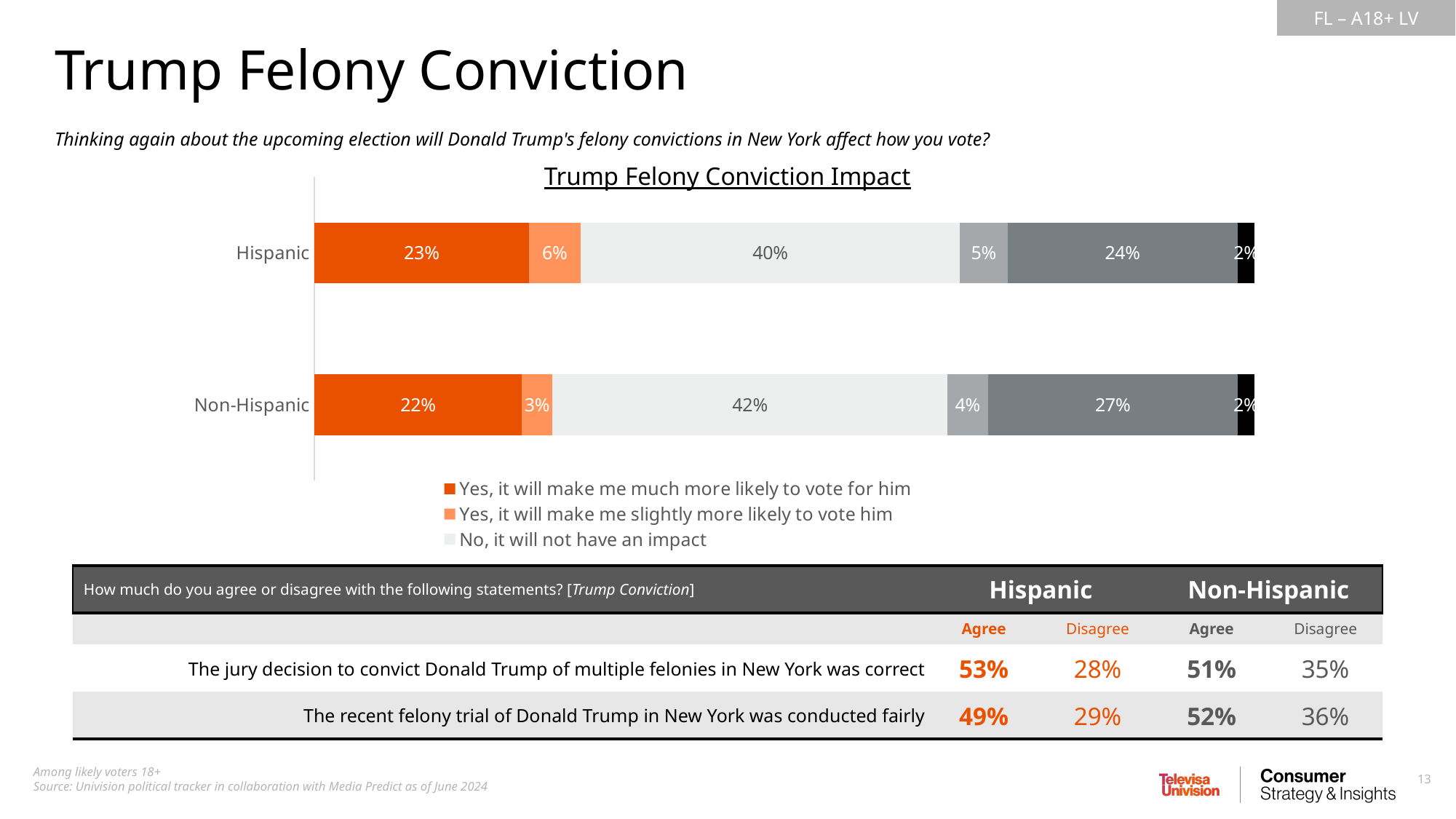
In the Trump Felony Conviction Impact chart, what percentage of Non-Hispanic respondents said the conviction will make them slightly more likely to vote for him? 3% In the Trump Felony Conviction Impact chart, which legend response has the largest share among Hispanic respondents? No, it will not have an impact In the Trump Felony Conviction Impact chart, what is the difference in percentage points between Hispanic and Non-Hispanic respondents who said the conviction will make them slightly more likely to vote for him? 3 percentage points How many entries are listed in the legend of the Trump Felony Conviction Impact chart? 3 In the Trump Felony Conviction Impact chart, what is the total of all segments in the Hispanic bar? 100% What type of chart is the Trump Felony Conviction Impact chart? Stacked bar chart In the Trump Felony Conviction Impact chart, which group has the larger share saying the conviction will not have an impact, Hispanic or Non-Hispanic? Non-Hispanic How many respondent groups are shown in the Trump Felony Conviction Impact chart? 2 In the Trump Felony Conviction Impact chart, what percentage of Hispanic respondents said the conviction will make them much more likely to vote for him? 23% What is the title of the chart on the slide? Trump Felony Conviction Impact In the Trump Felony Conviction Impact chart, what is the difference in percentage points between Hispanic and Non-Hispanic respondents who said the conviction will make them much more likely to vote for him? 1 percentage point In the Trump Felony Conviction Impact chart, what percentage of Non-Hispanic respondents said it will not have an impact? 42%